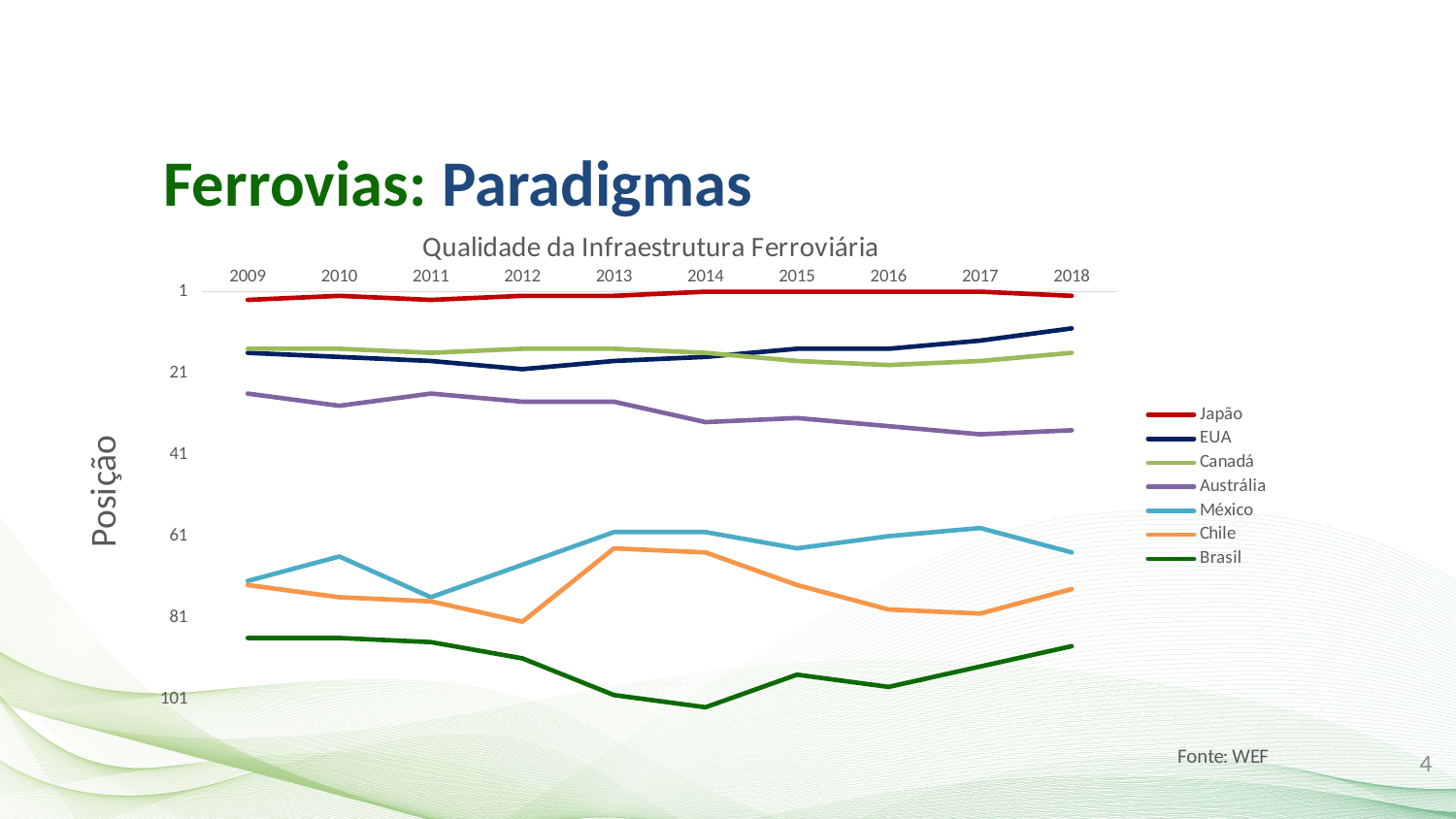
What kind of chart is shown on the slide? line chart Which series has the highest values across all years? Brasil Is the value for Brasil in 2014 greater or less than 81? greater What is the label on the vertical axis? Posição Is the value for Austrália in 2009 greater or less than 41? less How many years are shown along the x axis? 10 Which series has the lowest values across all years? Japão Is the value for México in 2013 greater or less than 41? greater How many series does the legend list? 7 Which has the larger value in 2014, Chile or Brasil? Brasil What is the title of the chart? Qualidade da Infraestrutura Ferroviária